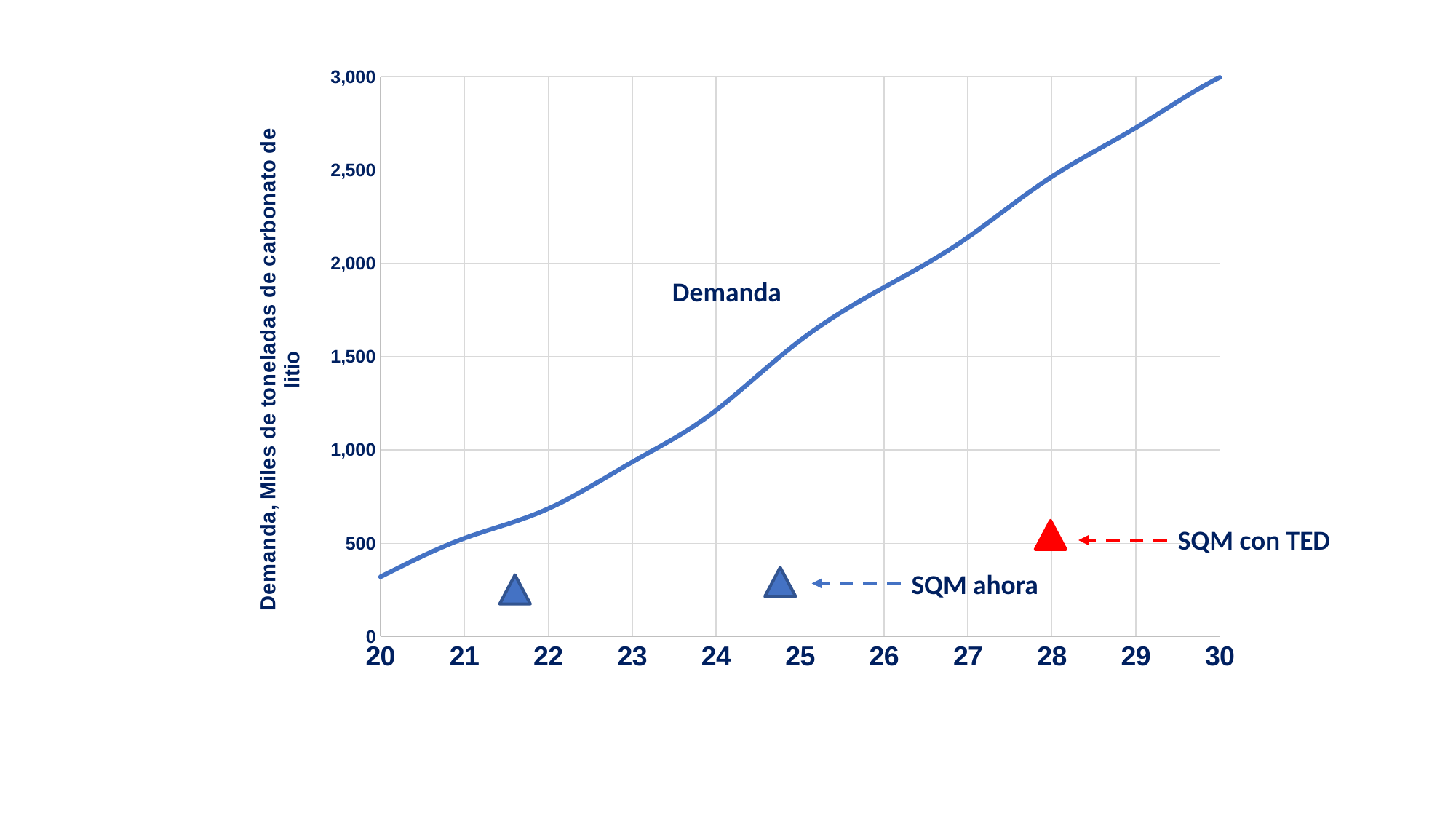
How many tick labels are shown on the x axis? 11 Is the value of the Demanda line at 20 greater or less than 500? less Does the Demanda line rise or fall as the x axis goes from 20 to 30? rise What kind of chart is shown on the slide? line chart Which is larger, the Demanda value at 27 or at 23? 27 Is the value of the Demanda line at 22 greater or less than 1,000? less Is the value of the Demanda line at 28 greater or less than 2,000? greater What label is attached to the red triangle marker? SQM con TED At which x-axis value is the Demanda line lowest? 20 At which x-axis value is the Demanda line highest? 30